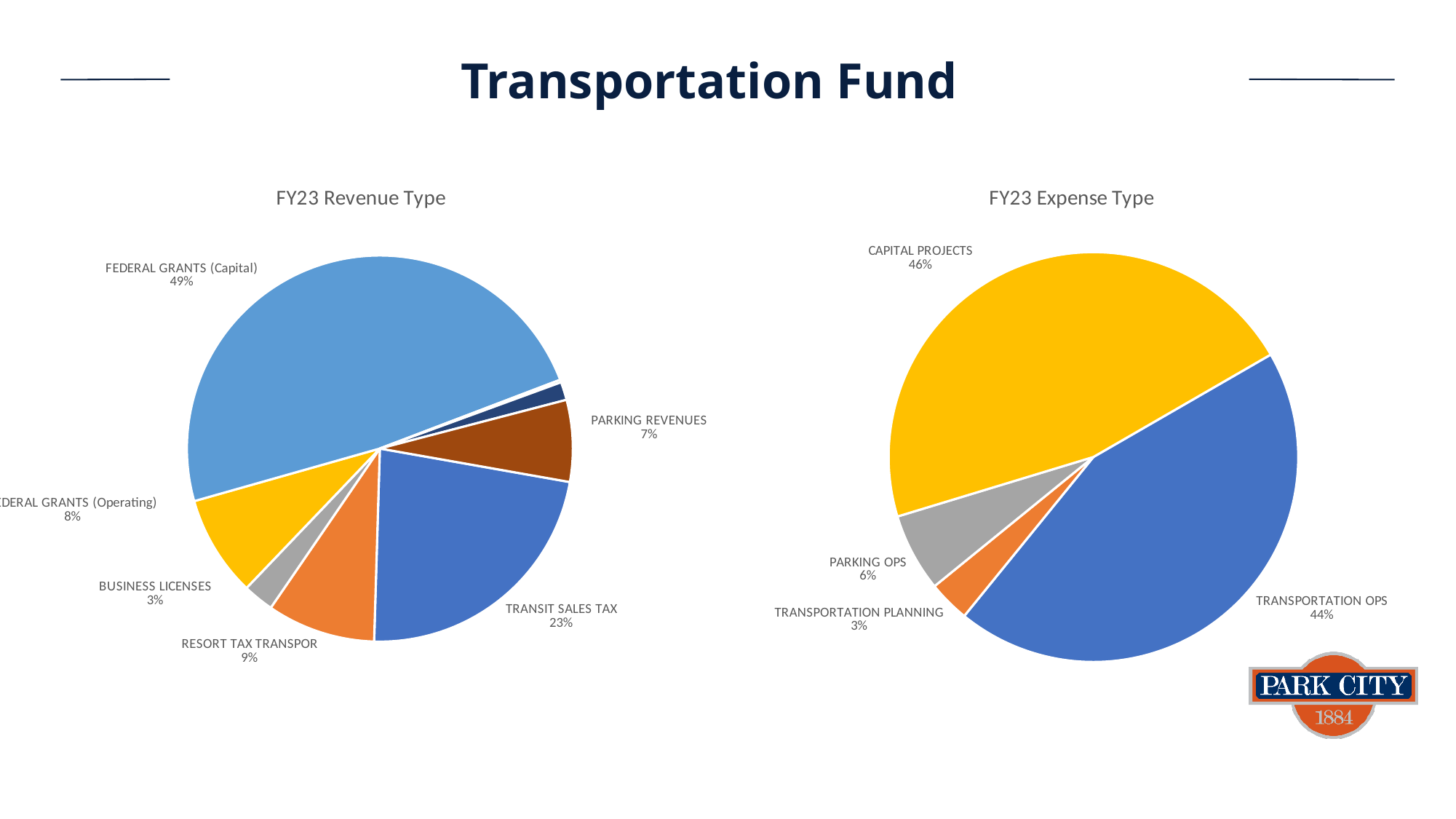
In the FY23 Revenue Type chart, what share does FEDERAL GRANTS (Capital) represent? 49% In the FY23 Revenue Type chart, which is larger, RESORT TAX TRANSPOR or FEDERAL GRANTS (Operating)? RESORT TAX TRANSPOR In the FY23 Revenue Type chart, what percentage is PARKING REVENUES? 7% In the FY23 Expense Type chart, how many slices does the pie have? 4 In the FY23 Revenue Type chart, which category has the largest share? FEDERAL GRANTS (Capital) In the FY23 Expense Type chart, which category has the smallest share? TRANSPORTATION PLANNING In the FY23 Revenue Type chart, what percentage is TRANSIT SALES TAX? 23% In the FY23 Expense Type chart, what share does CAPITAL PROJECTS represent? 46% What type of chart is used for FY23 Expense Type? Pie chart In the FY23 Expense Type chart, what is the difference in percentage points between CAPITAL PROJECTS and TRANSPORTATION OPS? 2 percentage points In the FY23 Revenue Type chart, what is the difference in percentage points between FEDERAL GRANTS (Capital) and TRANSIT SALES TAX? 26 percentage points In the FY23 Expense Type chart, what percentage is TRANSPORTATION OPS? 44%